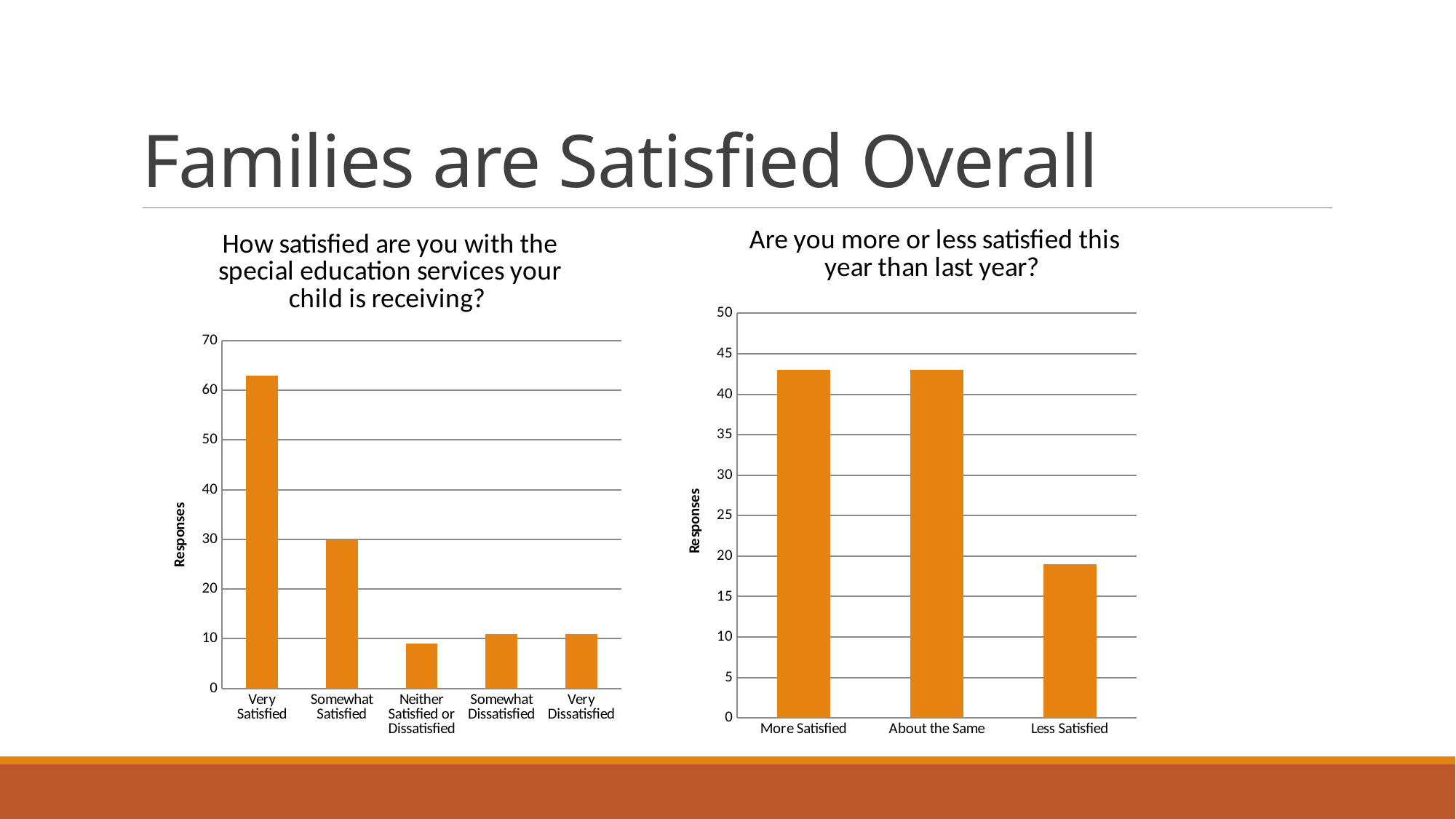
In the left chart, which category has the highest number of responses? Very Satisfied In the right chart, is the value for More Satisfied greater or less than 40? greater What kind of chart is the left chart, 'How satisfied are you with the special education services your child is receiving?'? bar chart In the left chart, which is larger: Somewhat Satisfied or Somewhat Dissatisfied? Somewhat Satisfied What is the y-axis label of the left chart? Responses In the right chart, which is larger: About the Same or Less Satisfied? About the Same In the right chart, is the value for Less Satisfied greater or less than 20? less In the left chart, is the value for Very Satisfied greater or less than 60? greater How many categories are shown on the x axis of the right chart? 3 In the right chart, 'Are you more or less satisfied this year than last year?', which category has the lowest number of responses? Less Satisfied How many categories are shown on the x axis of the left chart? 5